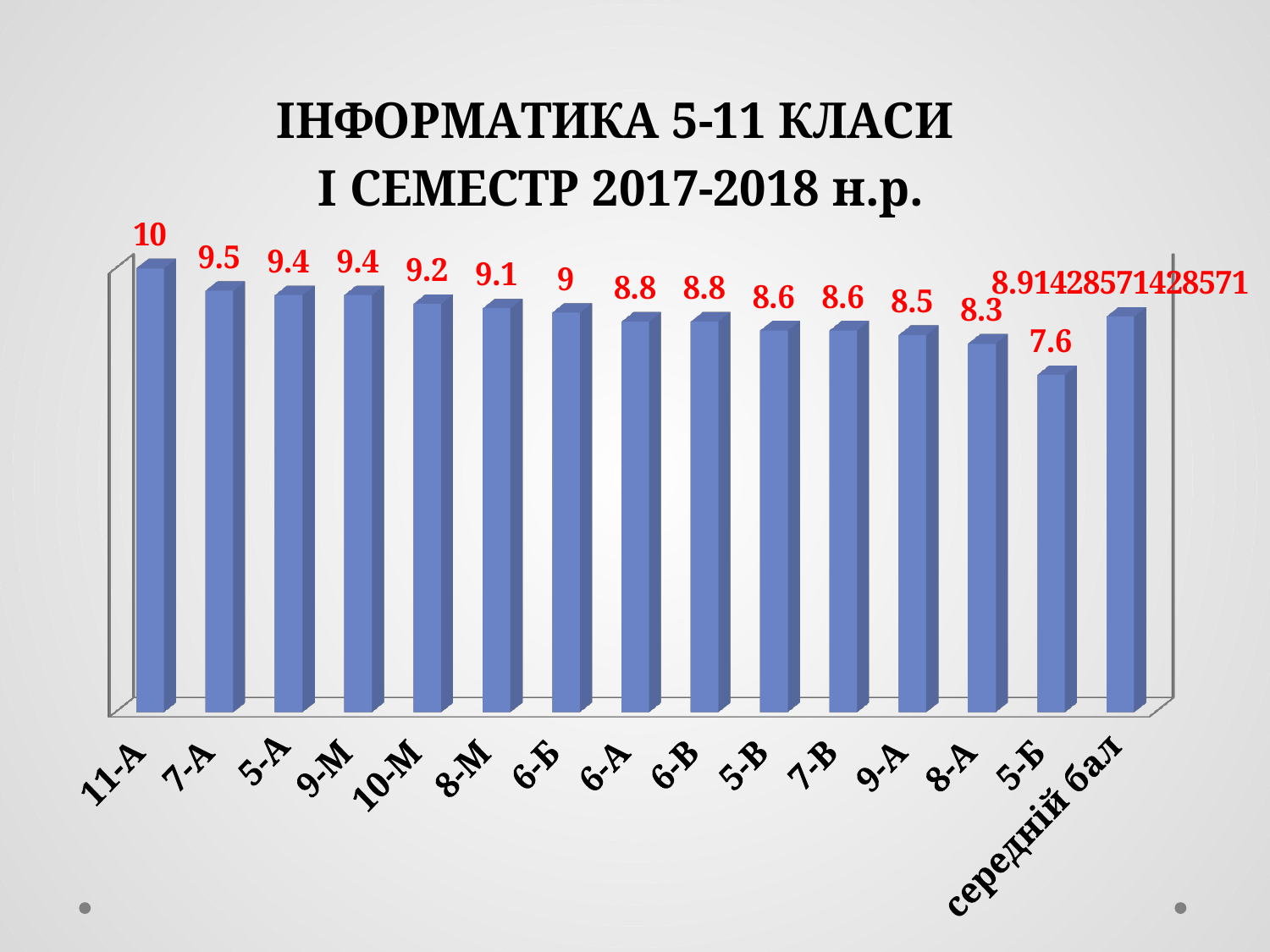
What kind of chart is shown on the slide? Bar chart What is the difference between the values for 11-А and 5-Б? 2.4 What value is shown for the 'середній бал' bar? 8.91428571428571 Which class has the lowest value? 5-Б What value is shown for class 11-А? 10 Which class has the highest value? 11-А What value is shown for class 10-М? 9.2 What value is shown for class 5-Б? 7.6 How many bars are shown in the chart? 15 What is the difference between the values for 7-А and 8-А? 1.2 Which has a larger value, 6-Б or 9-А? 6-Б What is the title of the chart? ІНФОРМАТИКА 5-11 КЛАСИ І СЕМЕСТР 2017-2018 н.р.